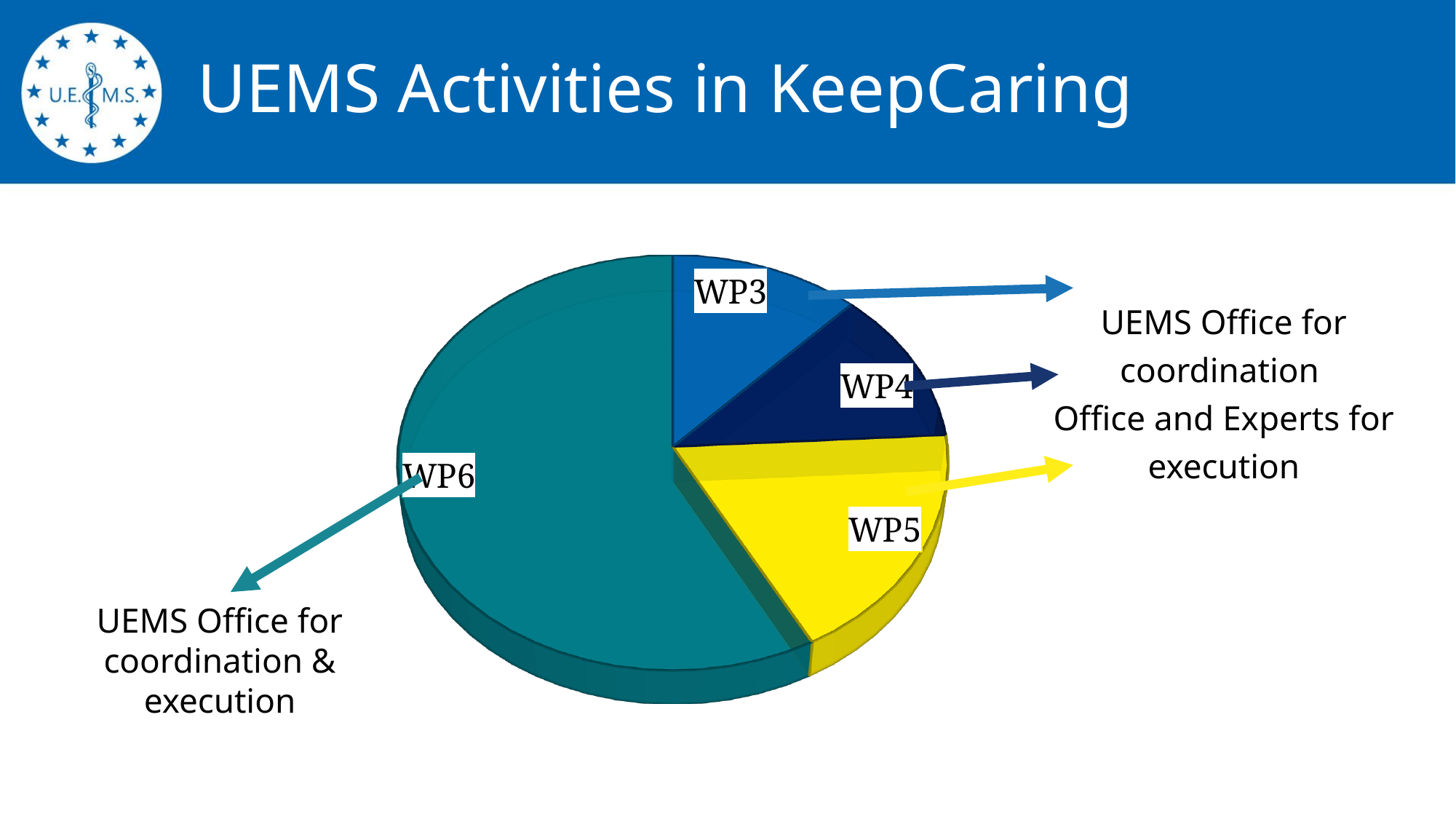
Does the WP6 slice take up more or less than half of the pie? More What colour is the WP5 slice of the pie chart? Yellow Which slice is larger, WP5 or WP3? WP5 Which slice is larger, WP6 or WP5? WP6 What kind of chart is shown on the slide? Pie chart Which slice is larger, WP6 or WP3? WP6 What is the title of the slide containing the pie chart? UEMS Activities in KeepCaring Which slice of the pie chart is the largest? WP6 How many slices does the pie chart have? 4